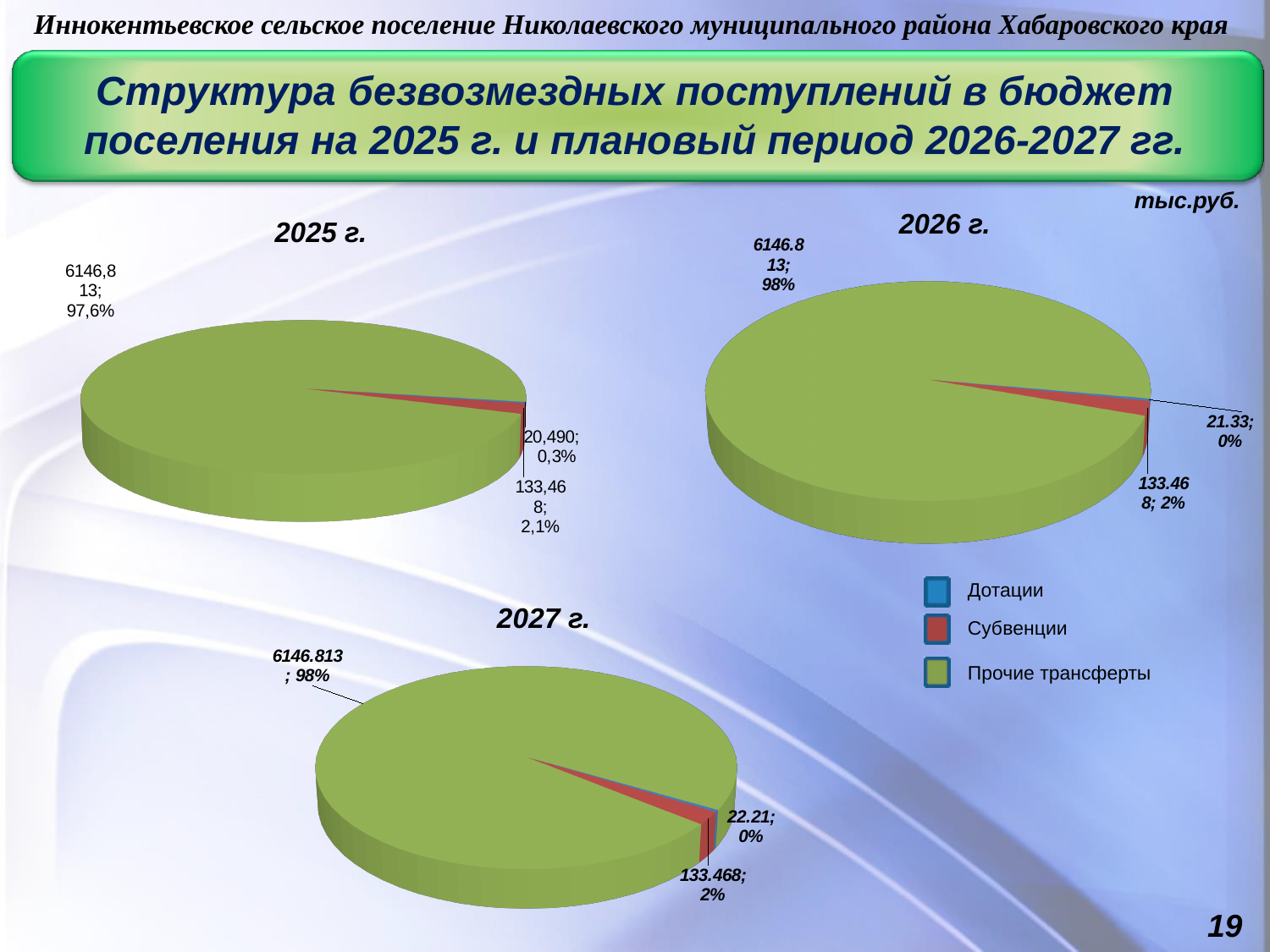
In the 2027 г. pie chart, which category has the largest slice? Прочие трансферты In the 2026 г. pie chart, what share does Субвенции have? 2% In the 2025 г. pie chart, which is larger: Субвенции or Дотации? Субвенции In the 2025 г. pie chart, what is the value for Дотации? 20,490 In the 2026 г. pie chart, what is the value for Дотации? 21.33 What kind of chart is used for the 2025 г. data? pie chart In the 2025 г. pie chart, what is the value for Субвенции? 133,468 How many entries does the legend list? 3 In the 2025 г. pie chart, what share does Прочие трансферты have? 97,6% In the 2027 г. pie chart, what is the value for Дотации? 22.21 In the 2026 г. pie chart, which category has the smallest slice? Дотации How many pie charts are shown on the slide? 3